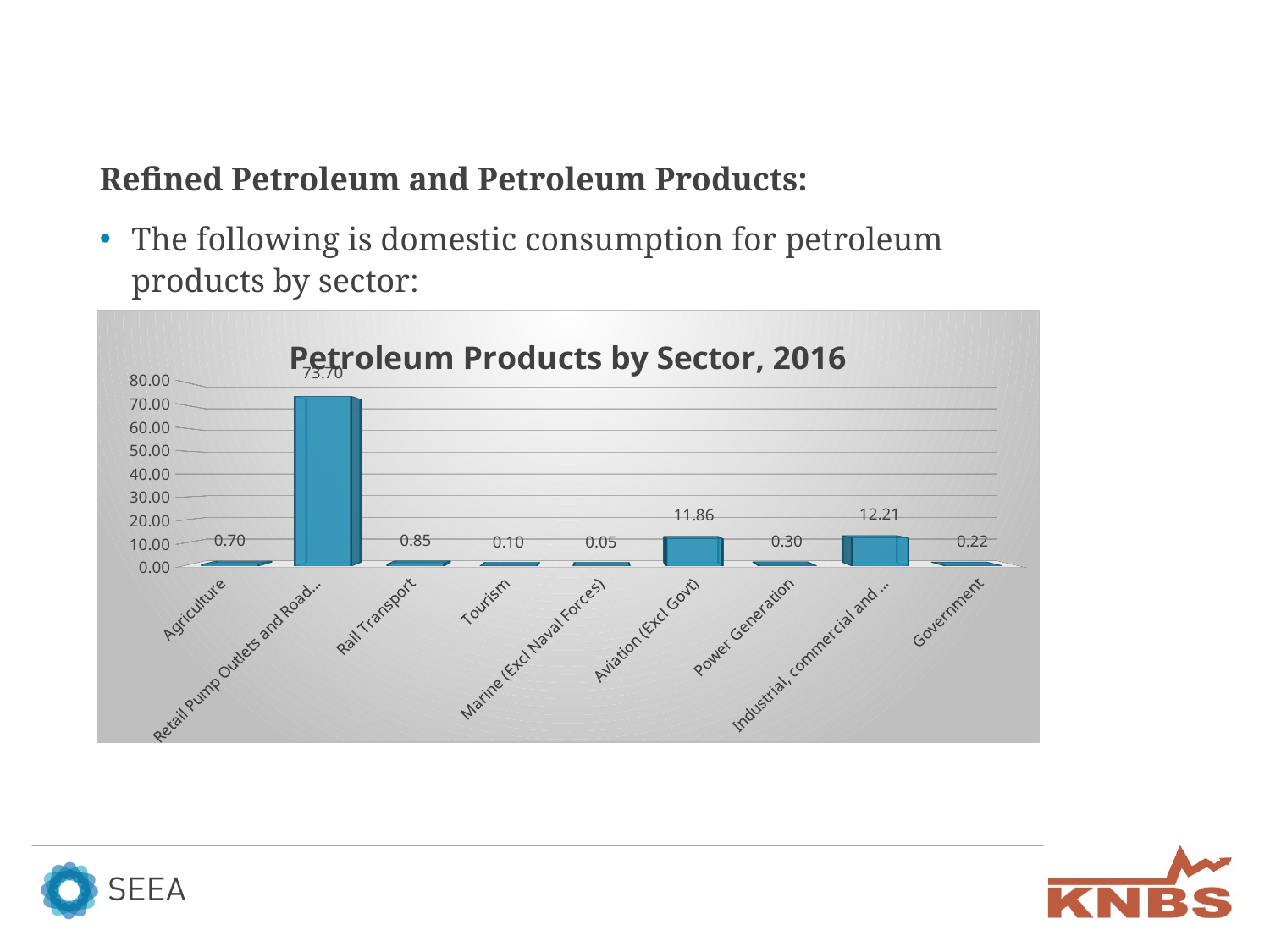
Is the value for Retail Pump Outlets and Road... greater or less than 70.00? greater What is the difference between the values for Industrial, commercial and ... and Aviation (Excl Govt)? 0.35 How many sectors are shown in the chart? 9 Which sector has the lowest value in the chart? Marine (Excl Naval Forces) What is the value for Government? 0.22 What is the value for Aviation (Excl Govt)? 11.86 What is the value for Agriculture in the Petroleum Products by Sector, 2016 chart? 0.70 Which is larger, the value for Rail Transport or the value for Power Generation? Rail Transport What is the value for Marine (Excl Naval Forces)? 0.05 Which sector has the highest value in the chart? Retail Pump Outlets and Road... What kind of chart is shown on the slide? Bar chart What is the title of the chart? Petroleum Products by Sector, 2016